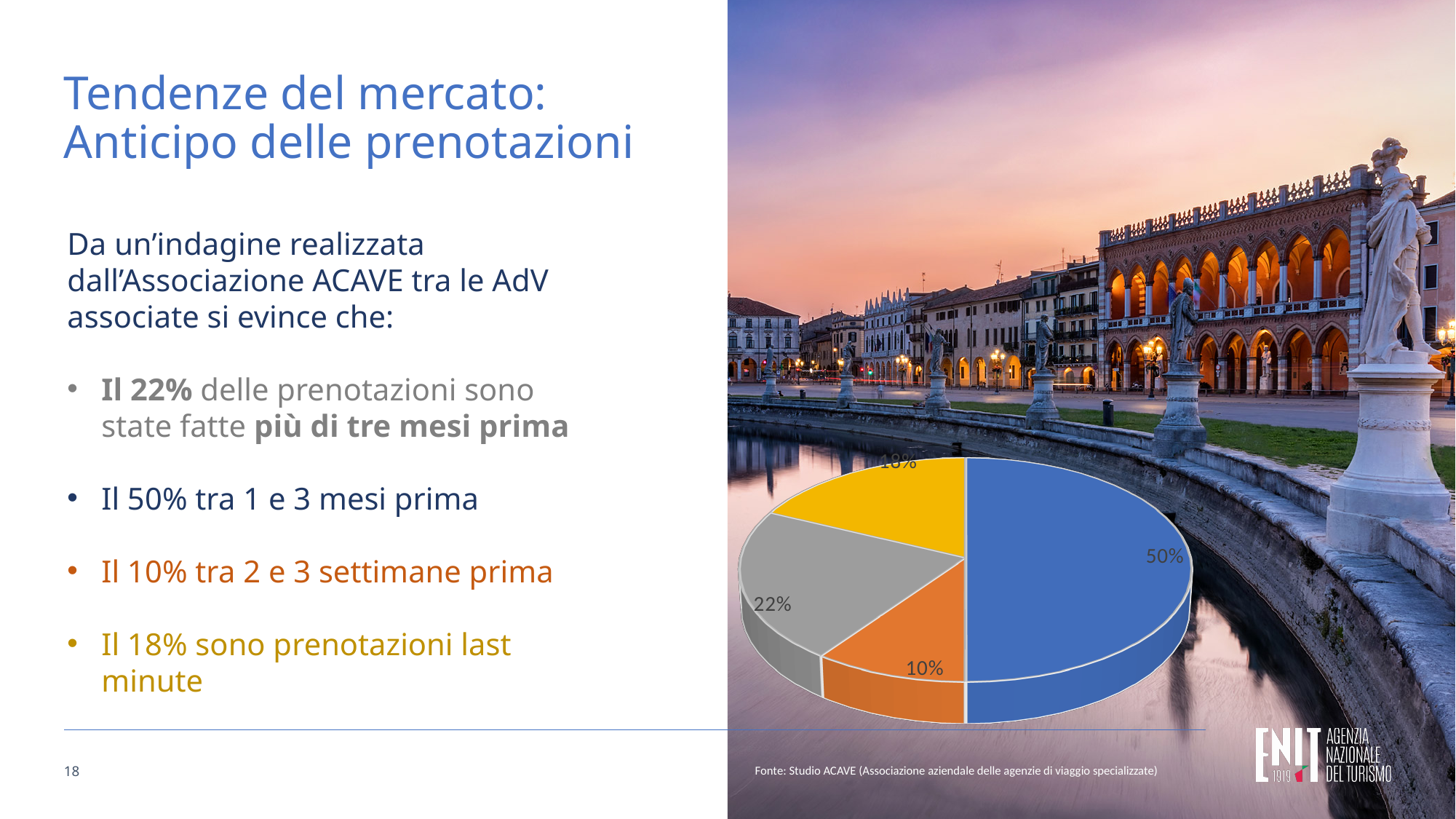
Which is larger in the pie chart, the grey slice or the yellow slice? The grey slice (22%) What percentage is shown on the orange slice of the pie chart? 10% Which slice of the pie chart is the smallest? The orange slice (10%) What percentage is shown on the blue slice of the pie chart? 50% Which slice of the pie chart is the largest? The blue slice (50%) What is the combined share of the orange and yellow slices in the pie chart? 28% What percentage is shown on the yellow slice of the pie chart? 18% What is the difference between the blue slice and the grey slice in the pie chart? 28 percentage points According to the slide, what share of bookings were made between 1 and 3 months in advance? 50% What percentage is shown on the grey slice of the pie chart? 22% How many slices does the pie chart have? 4 What kind of chart is shown on the slide? Pie chart